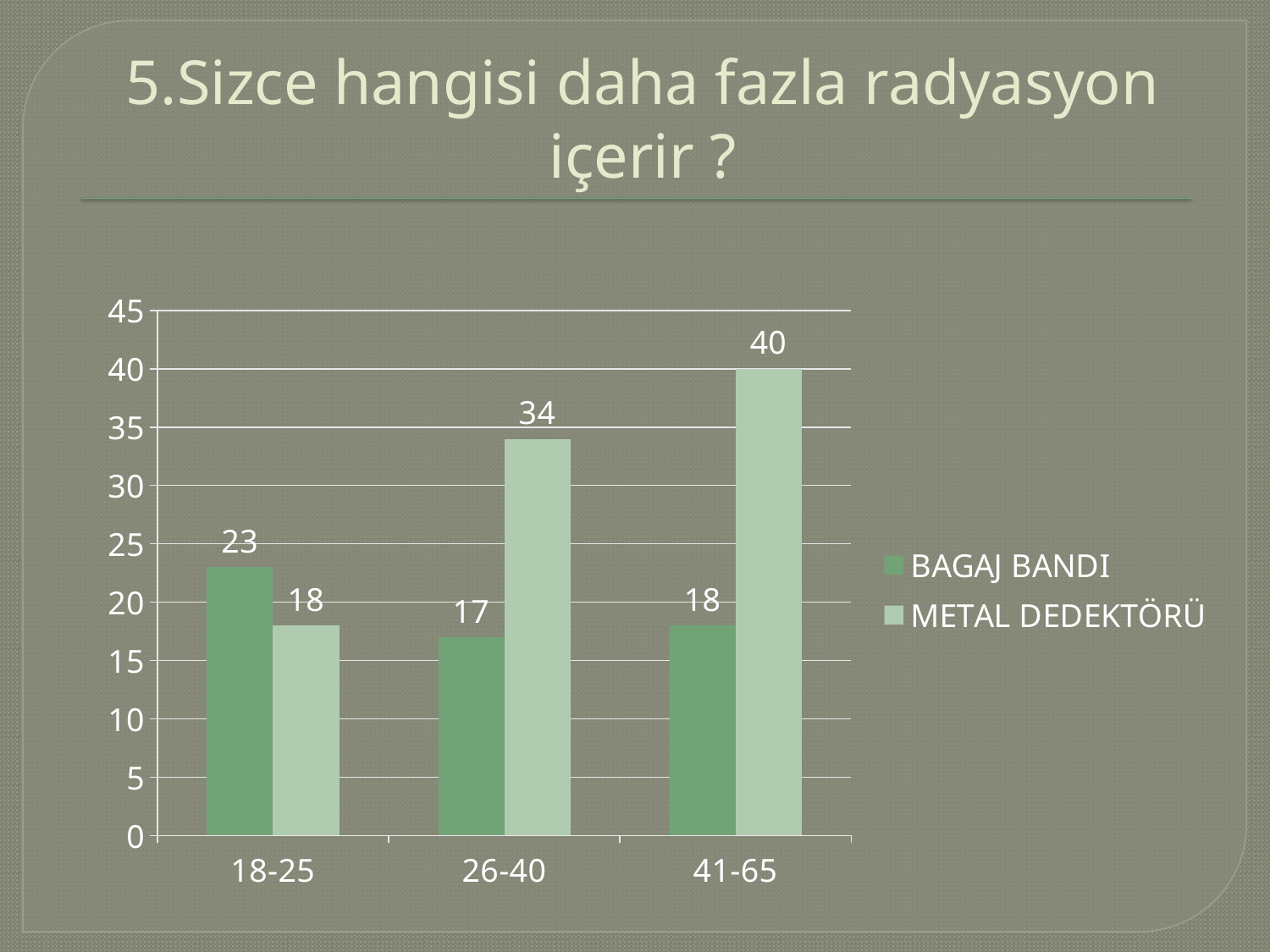
What is the value for BAGAJ BANDI in the 18-25 age group? 23 Is the value for METAL DEDEKTÖRÜ in the 26-40 age group greater or less than 30? greater Which age group has the lowest value for BAGAJ BANDI? 26-40 What kind of chart is shown on the slide? bar chart What is the value for METAL DEDEKTÖRÜ in the 26-40 age group? 34 Do the METAL DEDEKTÖRÜ values rise or fall from the 18-25 group to the 41-65 group? rise Which age group has the highest value for METAL DEDEKTÖRÜ? 41-65 How many age groups are shown on the x axis? 3 In the 18-25 age group, which is larger: BAGAJ BANDI or METAL DEDEKTÖRÜ? BAGAJ BANDI How many series does the legend list? 2 What is the difference between METAL DEDEKTÖRÜ and BAGAJ BANDI in the 41-65 age group? 22 What is the value for METAL DEDEKTÖRÜ in the 41-65 age group? 40